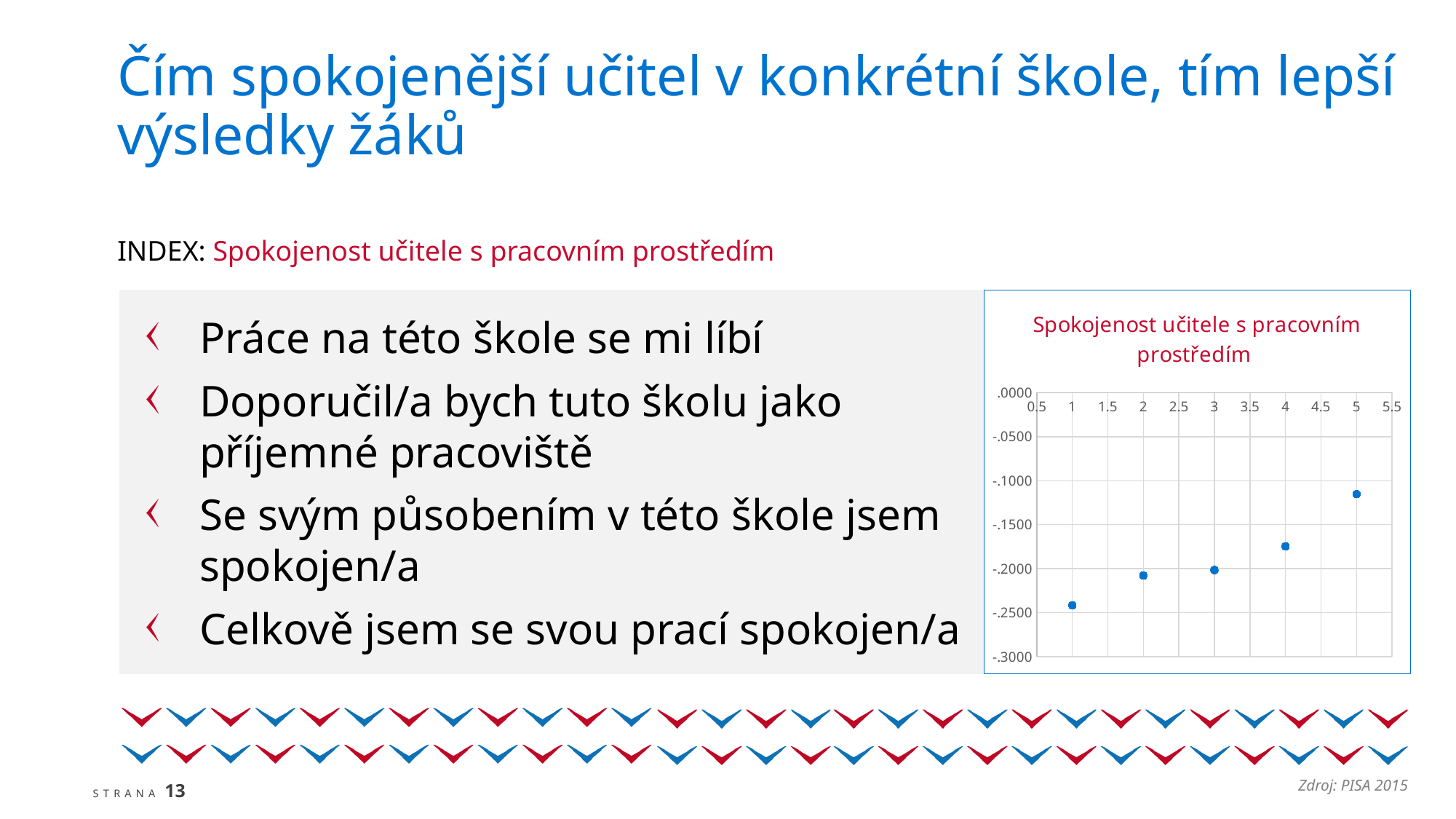
How many data points are plotted in the chart? 5 Is the value plotted at x = 5 greater or less than -.1500? greater Is the value plotted at x = 4 greater or less than -.2000? greater Is the value plotted at x = 1 greater or less than -.2000? less What is the title of the chart? Spokojenost učitele s pracovním prostředím What kind of chart is shown on the slide? scatter plot Which point has the higher value: the one at x = 1 or the one at x = 5? x = 5 Do the plotted values rise or fall as the x value increases from 1 to 5? rise What is the lowest value shown on the chart's vertical axis? -.3000 At which x value is the plotted point highest? 5 At which x value is the plotted point lowest? 1